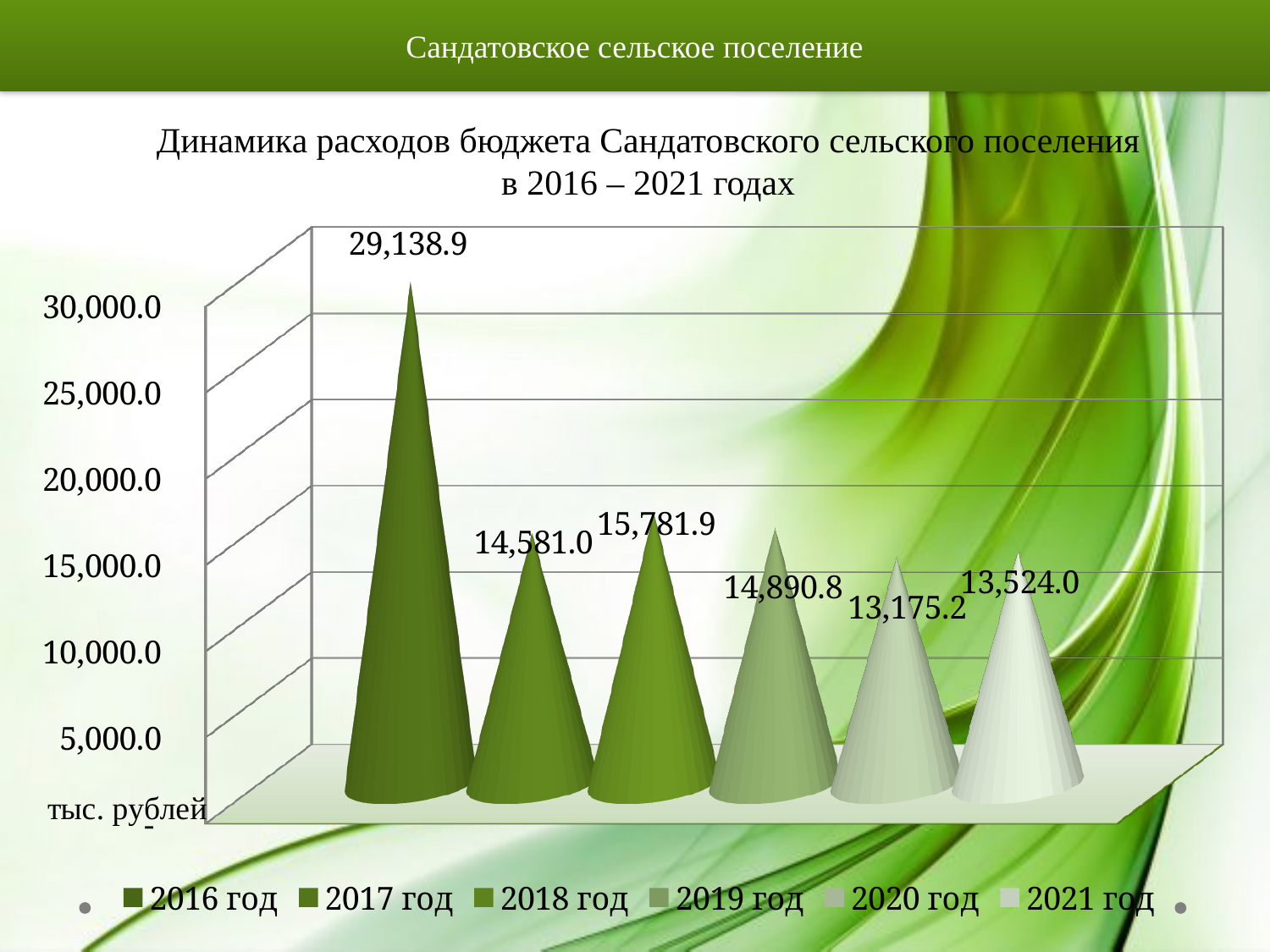
What is the difference between the values for 2016 год and 2017 год? 14,557.9 What is the difference between the values for 2021 год and 2020 год? 348.8 Which year has the highest expenditure value? 2016 год Which year has the lowest expenditure value? 2020 год How many years are plotted on the chart? 6 What is the budget expenditure value shown for 2016 год? 29,138.9 How many entries does the legend list? 6 What is the value shown for 2018 год? 15,781.9 What is the value shown for 2021 год? 13,524.0 What unit of measurement is indicated on the chart? тыс. рублей Which is larger, the value for 2018 год or the value for 2019 год? 2018 год What is the value shown for 2020 год? 13,175.2